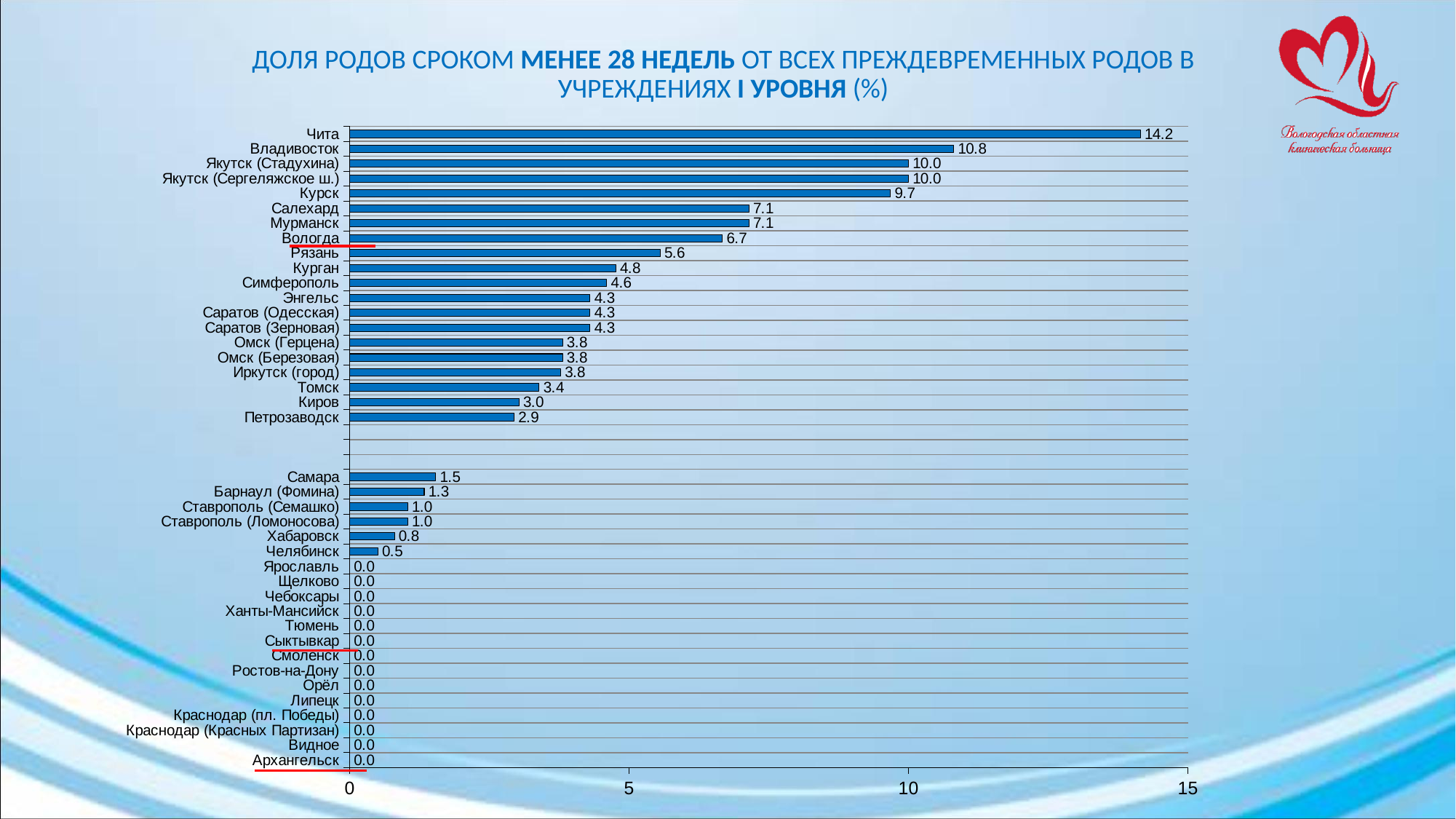
How many categories have a value of 0.0? 14 What is the value for Чита? 14.2 Is the value for Вологда greater or less than 5? greater What is the difference between the values for Чита and Владивосток? 3.4 Do the values rise or fall going from the top category to the bottom category? fall Which category has the highest value? Чита What is the value for Петрозаводск? 2.9 What is the value for Вологда? 6.7 What is the difference between the values for Вологда and Рязань? 1.1 Which is larger, the value for Курск or the value for Салехард? Курск What is the value for Челябинск? 0.5 What kind of chart is shown on the slide? bar chart